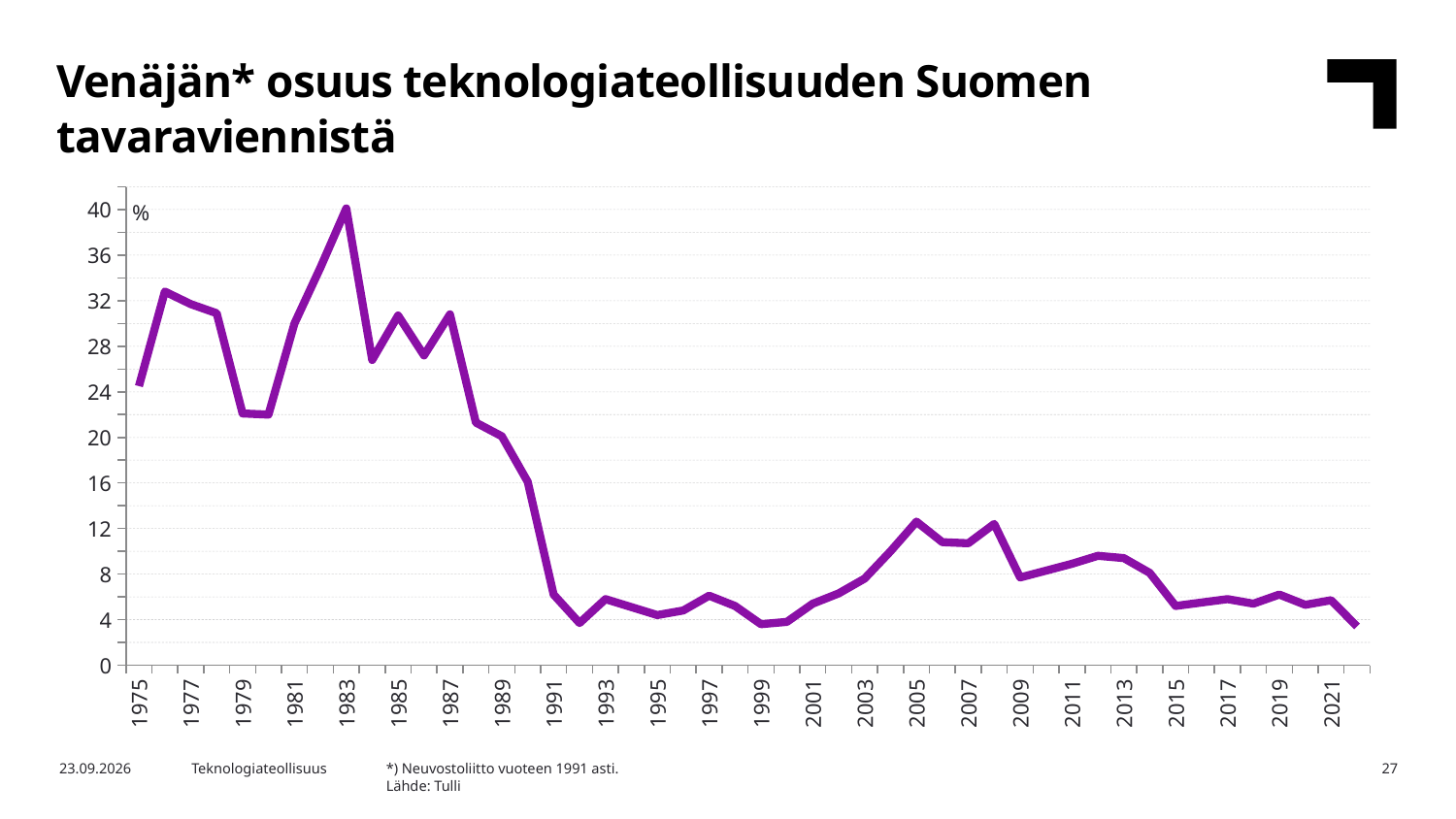
In which year does the line reach its highest value? 1983 Is the value for 1975 greater or less than 20? greater Is the value for 1983 greater or less than 36? greater What is the title of the chart? Venäjän* osuus teknologiateollisuuden Suomen tavaraviennistä Which year has the larger value, 1983 or 1985? 1983 Which year has the larger value, 1975 or 2021? 1975 Is the value for 2005 greater or less than 8? greater Overall, does the line rise or fall from 1975 to 2021? fall What kind of chart is shown on the slide? line chart